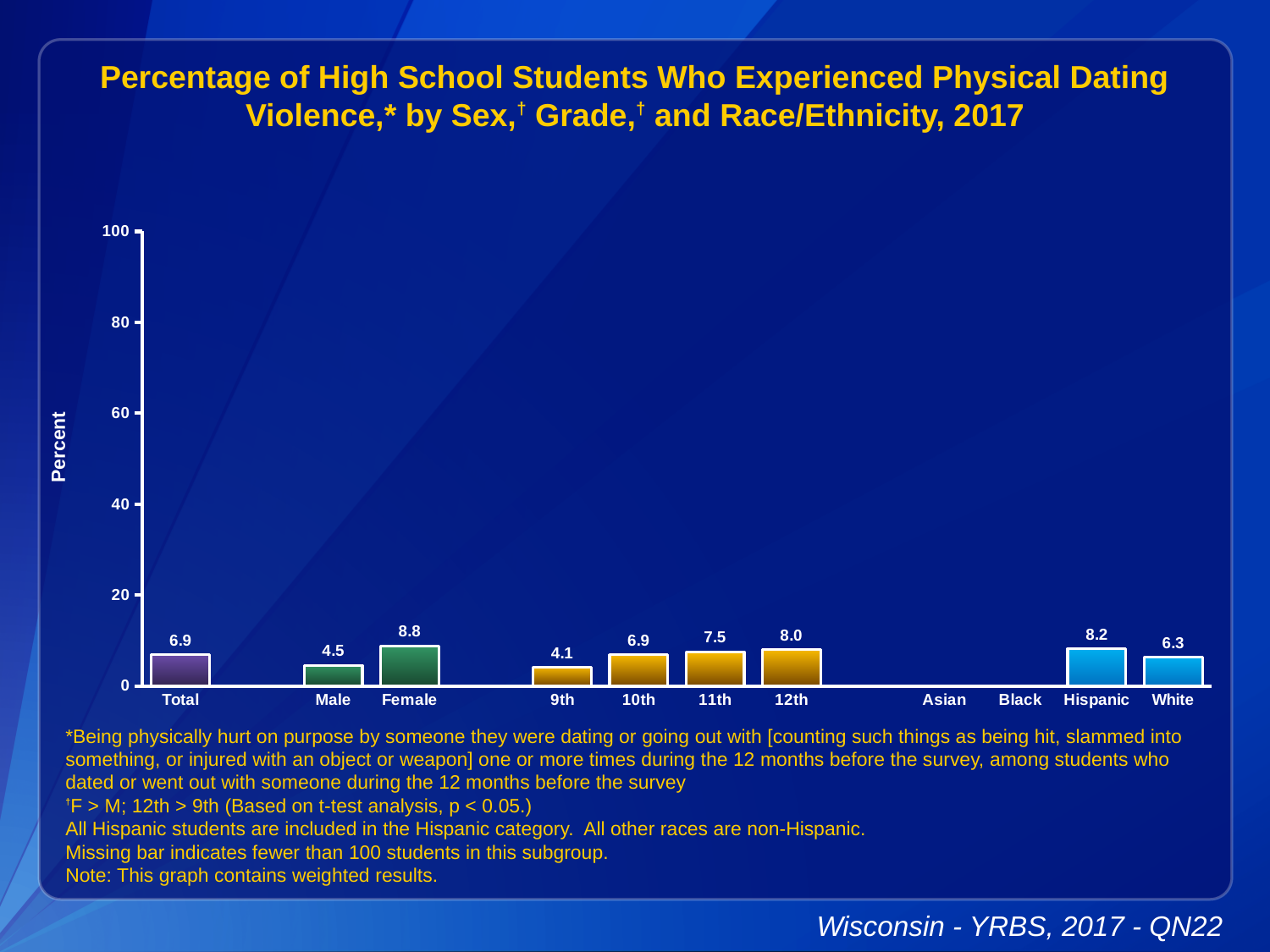
What kind of chart is shown on the slide? bar chart What is the value for 9th grade? 4.1 Which categories on the x axis have no bar shown? Asian and Black Which category has the lowest value among the bars shown? 9th What is the difference between the Female and Male values? 4.3 What is the value for Female? 8.8 What is the value for Total? 6.9 Which category has the highest value? Female What is the value for Hispanic? 8.2 Do the values rise or fall from 9th grade to 12th grade? rise Is the value for White greater or less than 20? less Which is larger, the value for 12th grade or the value for 10th grade? 12th